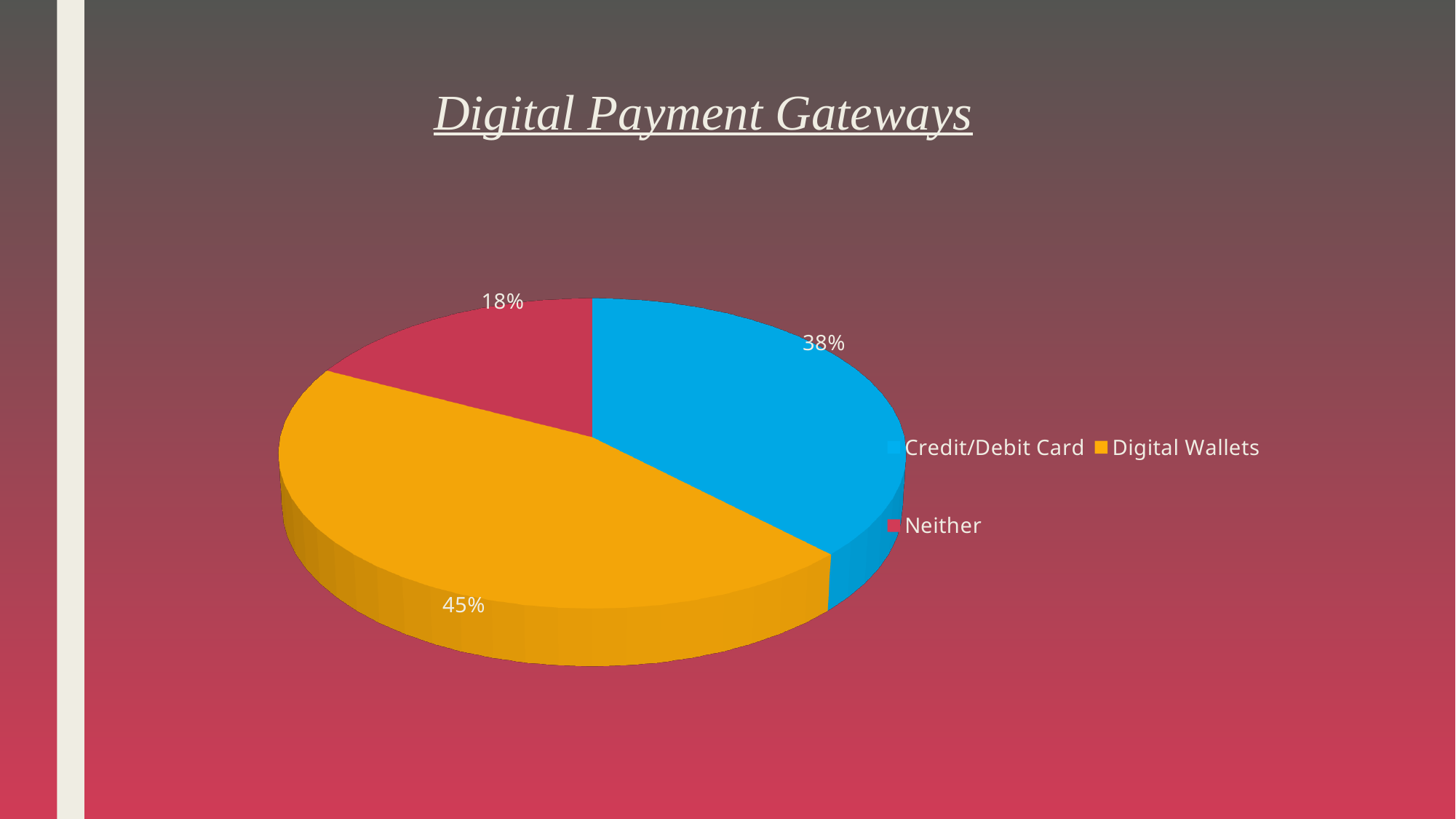
What colour is the Credit/Debit Card slice? blue What is the title of the slide? Digital Payment Gateways How many slices does the pie chart have? 3 What percentage of the pie is Credit/Debit Card? 38% Which category has the smallest share of the pie? Neither Which is larger, the share for Credit/Debit Card or the share for Neither? Credit/Debit Card Which category has the largest share of the pie? Digital Wallets What type of chart is shown on the slide? pie chart What percentage of the pie is Neither? 18% What is the difference in percentage points between Credit/Debit Card and Neither? 20 What is the difference in percentage points between Digital Wallets and Credit/Debit Card? 7 What percentage of the pie is Digital Wallets? 45%